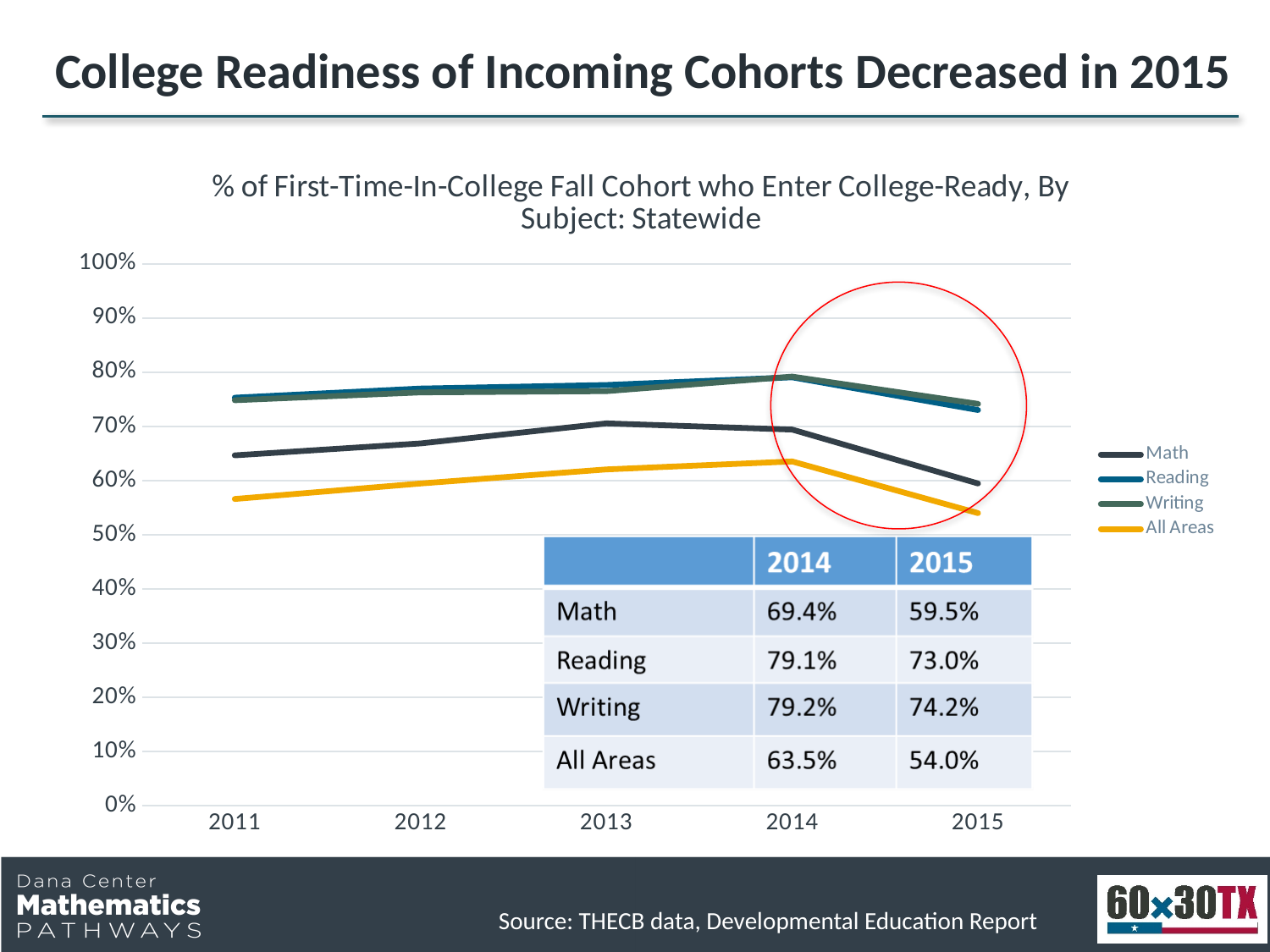
Is the All Areas value for 2011 greater or less than 60%? less Does the All Areas line rise or fall from 2011 to 2014? Rise By how many percentage points did the Math value fall from 2014 to 2015? 9.9 percentage points How many series does the legend list? 4 What is the All Areas value for 2015? 54.0% What is the Math value for 2015? 59.5% Which subject has the highest value in 2015? Writing Which series has the lowest value in 2015? All Areas What type of chart is shown on the slide? Line chart What is the Reading value for 2014? 79.1% Which is larger in 2015, the Writing value or the Reading value? Writing How many years are shown along the x axis? 5